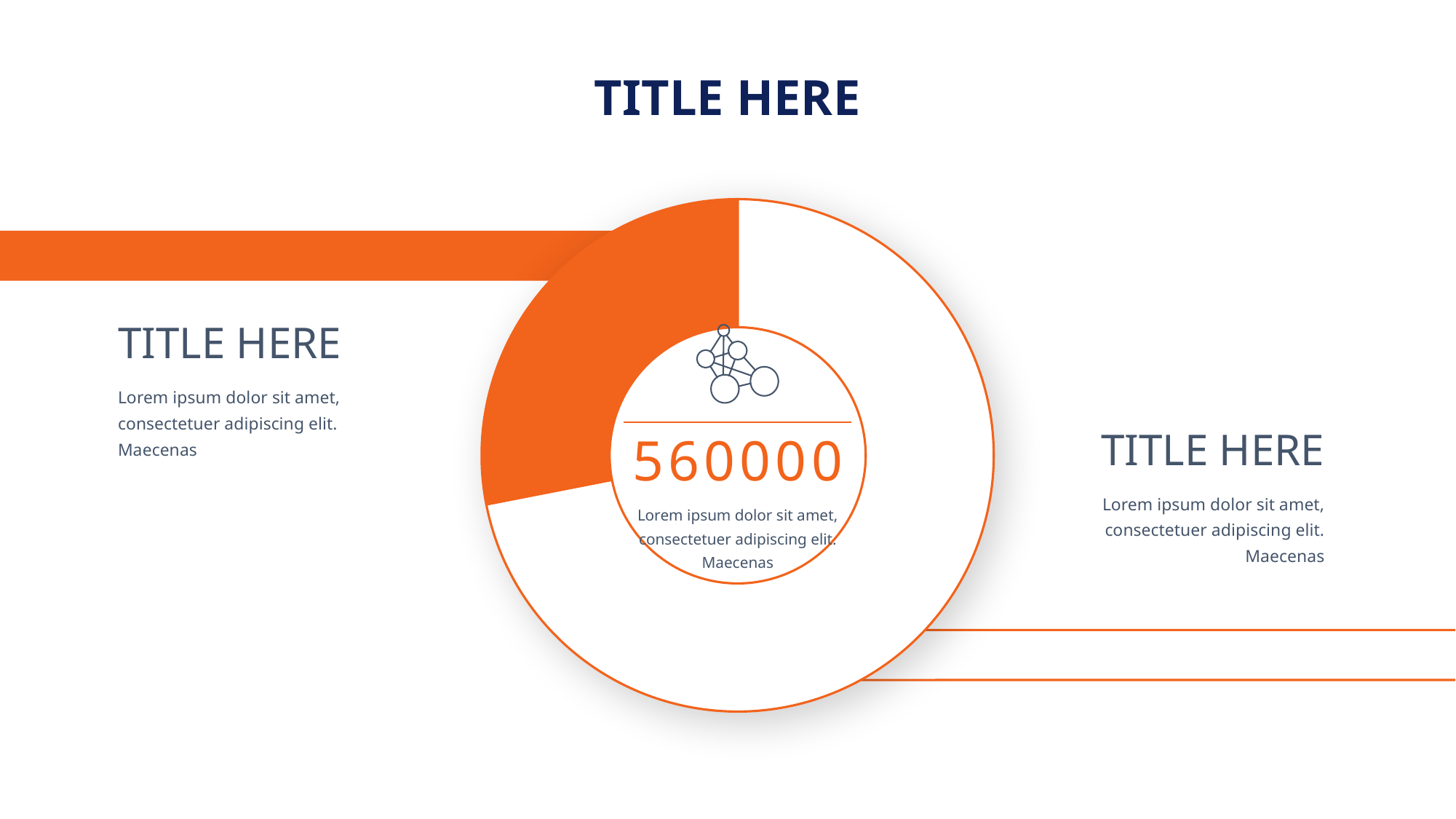
Which segment of the doughnut chart is the smallest? the orange segment What number is displayed in the centre of the doughnut chart? 560000 How many segments does the doughnut chart have? 2 What kind of chart is shown on the slide? doughnut chart Which segment of the doughnut chart is larger, the orange one or the white one? white What is the title shown at the top of the slide above the chart? TITLE HERE